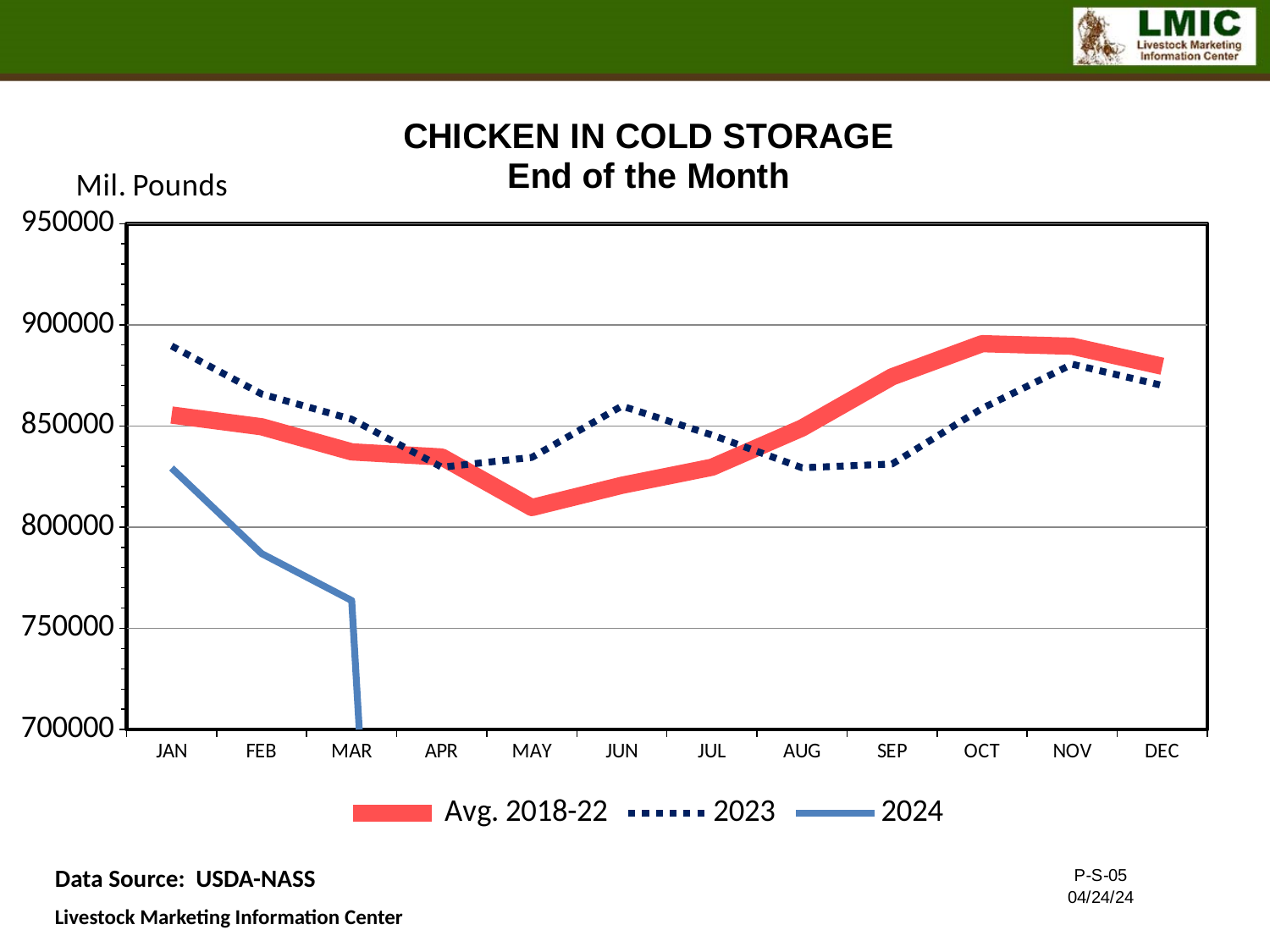
In JAN, which is larger: the 2023 value or the Avg. 2018-22 value? 2023 In OCT, which is larger: the 2023 value or the Avg. 2018-22 value? Avg. 2018-22 Is the Avg. 2018-22 value for MAY greater or less than 850000? less Is the 2023 value for JAN greater or less than 850000? greater Is the 2024 value for MAR greater or less than 800000? less What kind of chart is shown on the slide? Line chart How many months are shown along the x axis? 12 Which month has the lowest Avg. 2018-22 value? MAY How many series does the legend list? 3 Does the 2024 series rise or fall from JAN to MAR? Fall For how many months is the 2024 series plotted? 3